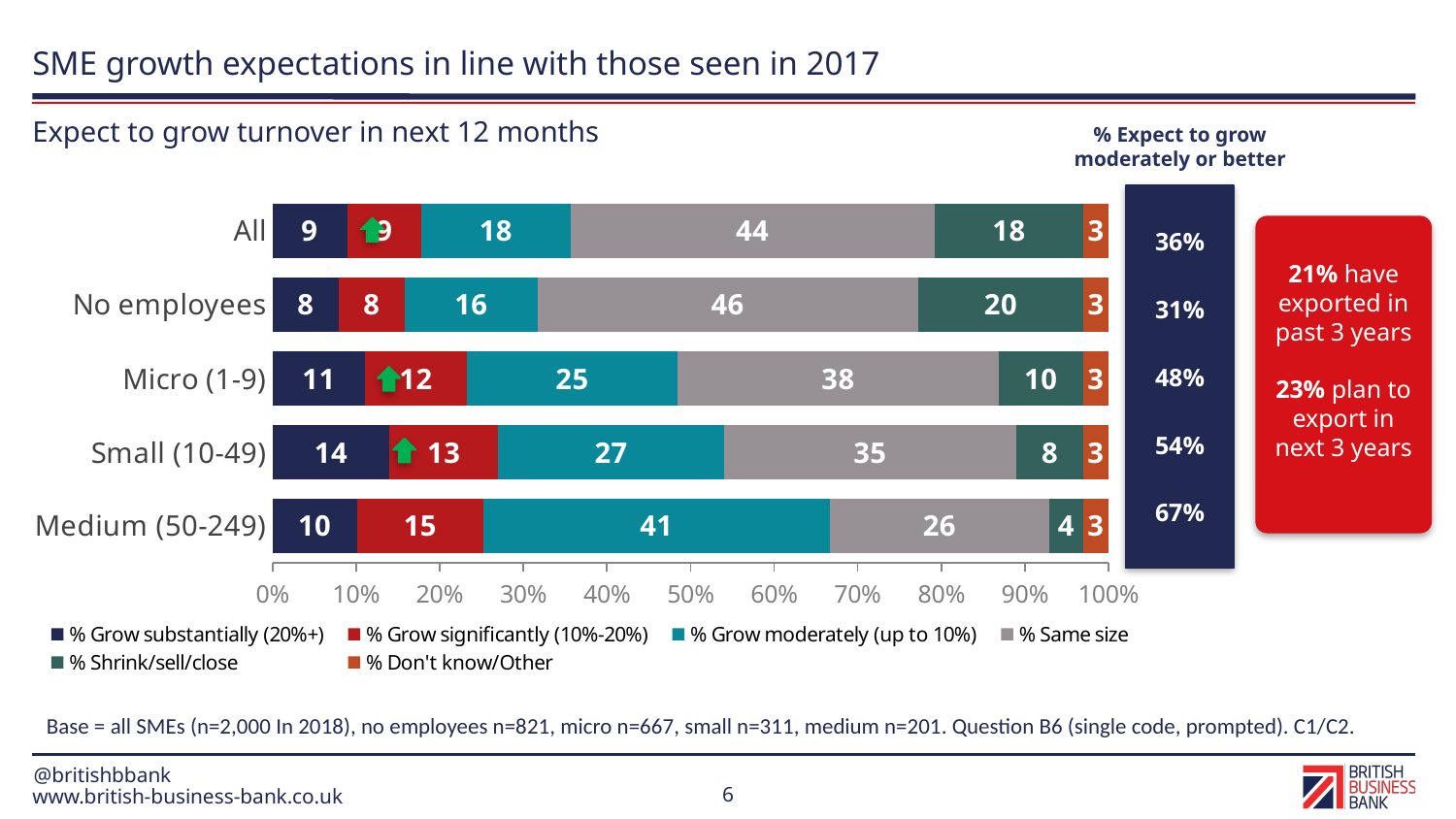
What is the % Grow moderately (up to 10%) value for Medium (50-249)? 41 What is the % Grow substantially (20%+) value for Small (10-49)? 14 What is the % Same size value for No employees? 46 Which category has the lowest % Same size value? Medium (50-249) Which category has the highest % Grow moderately (up to 10%) value? Medium (50-249) What is the % Expect to grow moderately or better figure for Micro (1-9)? 48% How many SME size categories are shown on the chart? 5 Moving down the chart from No employees to Medium (50-249), does the % Expect to grow moderately or better figure rise or fall? Rise What type of chart is used to show expectations to grow turnover in the next 12 months? Stacked bar chart What is the difference between the % Same size value for All and for Medium (50-249)? 18 How many series does the chart legend list? 6 Which has a larger % Shrink/sell/close value, No employees or Small (10-49)? No employees